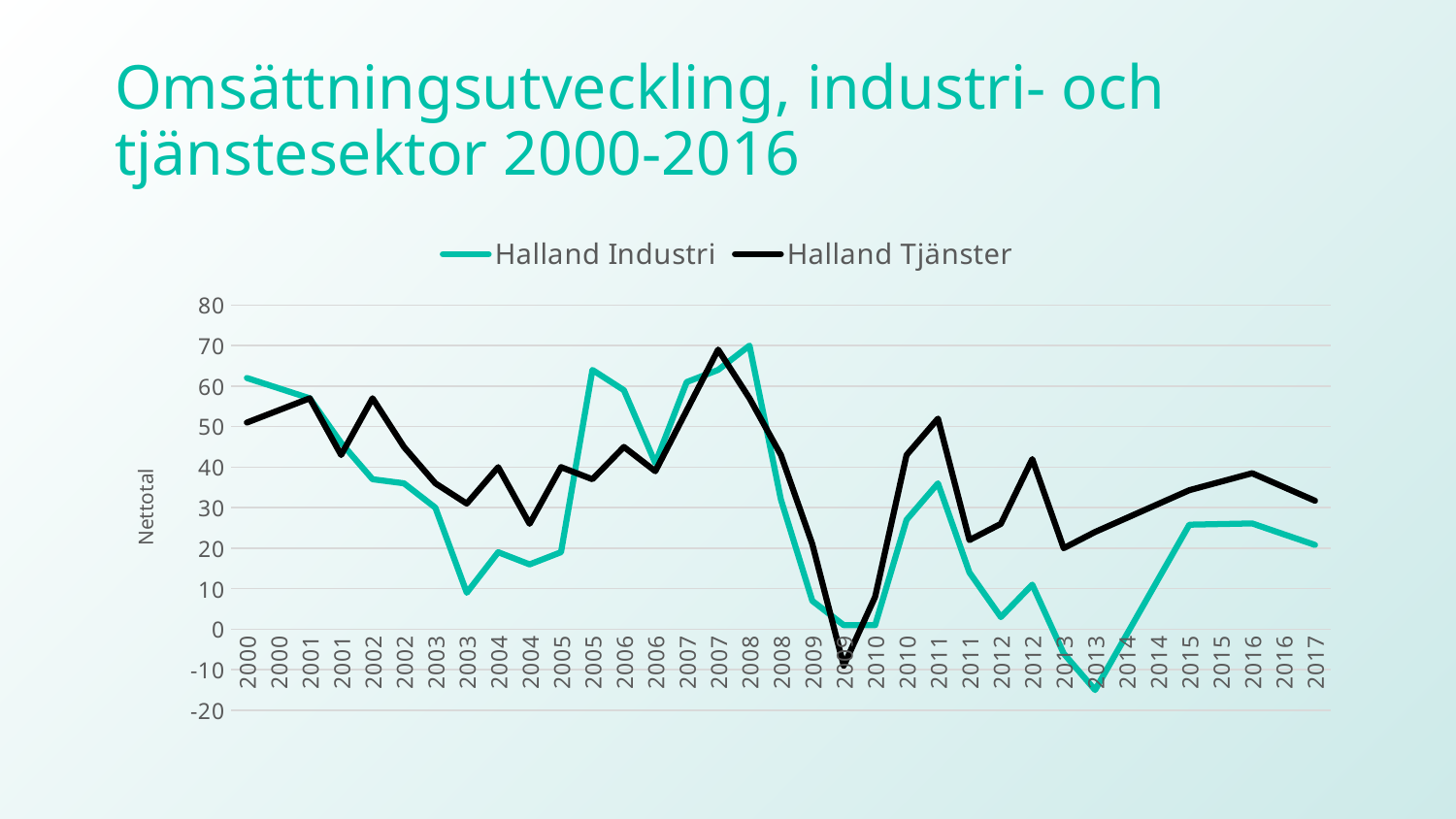
Is the value for Halland Tjänster at 2017 greater or less than 20? greater At 2017, which series has the higher value, Halland Industri or Halland Tjänster? Halland Tjänster Is the value for Halland Industri at the first 2000 point greater or less than 50? greater What kind of chart is shown on the slide? line chart Is the value for Halland Industri at the second 2003 point greater or less than 20? less At the first 2000 point, which series has the higher value, Halland Industri or Halland Tjänster? Halland Industri What is the label on the vertical axis? Nettotal Does the Halland Industri line rise or fall between the second 2013 point and the first 2015 point? rise How many series does the legend list? 2 What is the title of the chart on the slide? Omsättningsutveckling, industri- och tjänstesektor 2000-2016